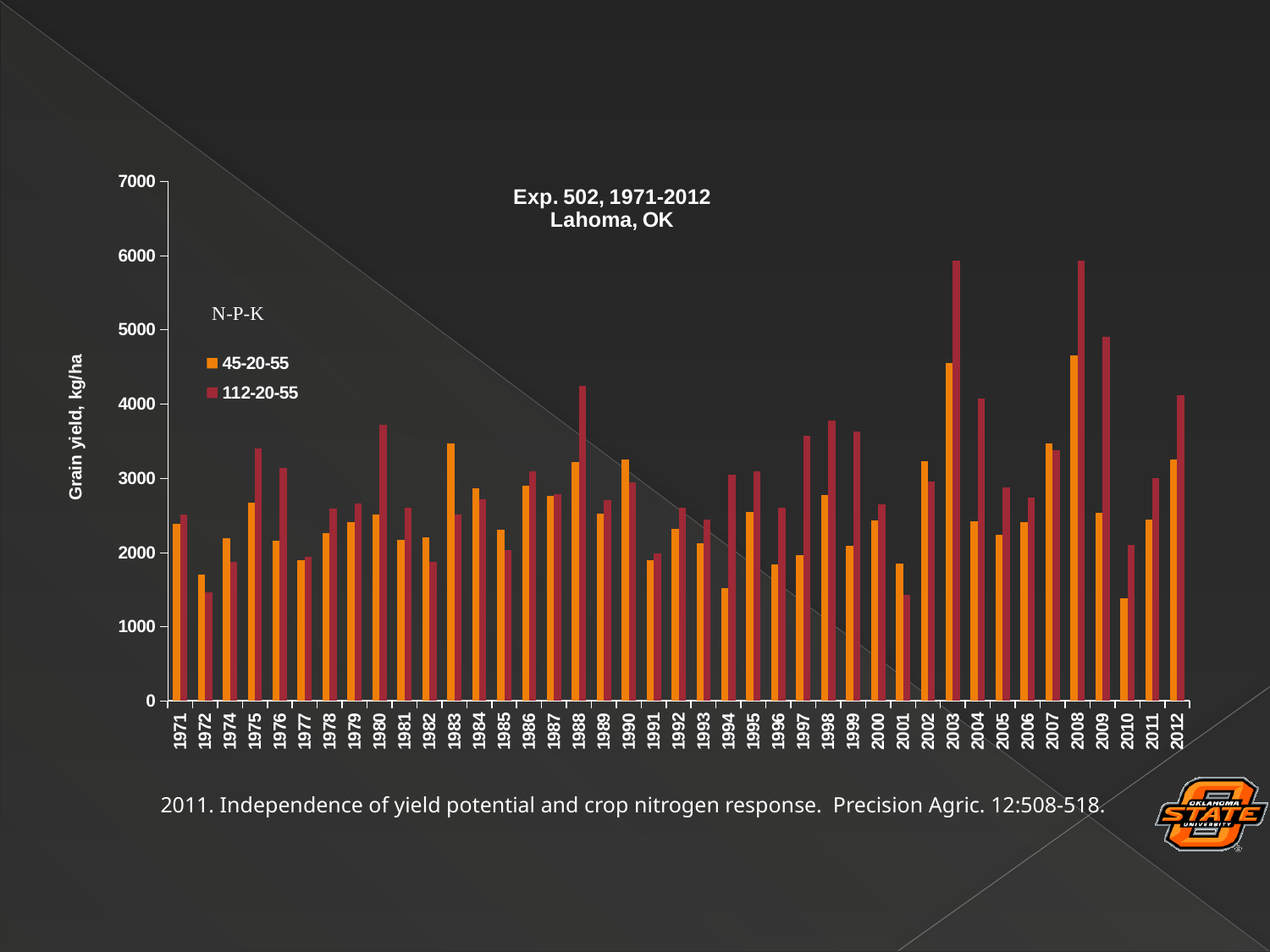
Is the 112-20-55 value for 1988 greater or less than 4000? greater Which year has the lowest grain yield for the 45-20-55 treatment? 2010 How many years are shown on the x axis? 41 Is the 45-20-55 value for 1972 greater or less than 2000? less What is the title of the chart? Exp. 502, 1971-2012 Lahoma, OK What is the y-axis label of the chart? Grain yield, kg/ha Is the 112-20-55 value for 2003 greater or less than 5000? greater In 1983, which treatment has the higher grain yield, 45-20-55 or 112-20-55? 45-20-55 In 1975, which treatment has the higher grain yield, 45-20-55 or 112-20-55? 112-20-55 What kind of chart is shown on the slide? bar chart How many series does the legend list? 2